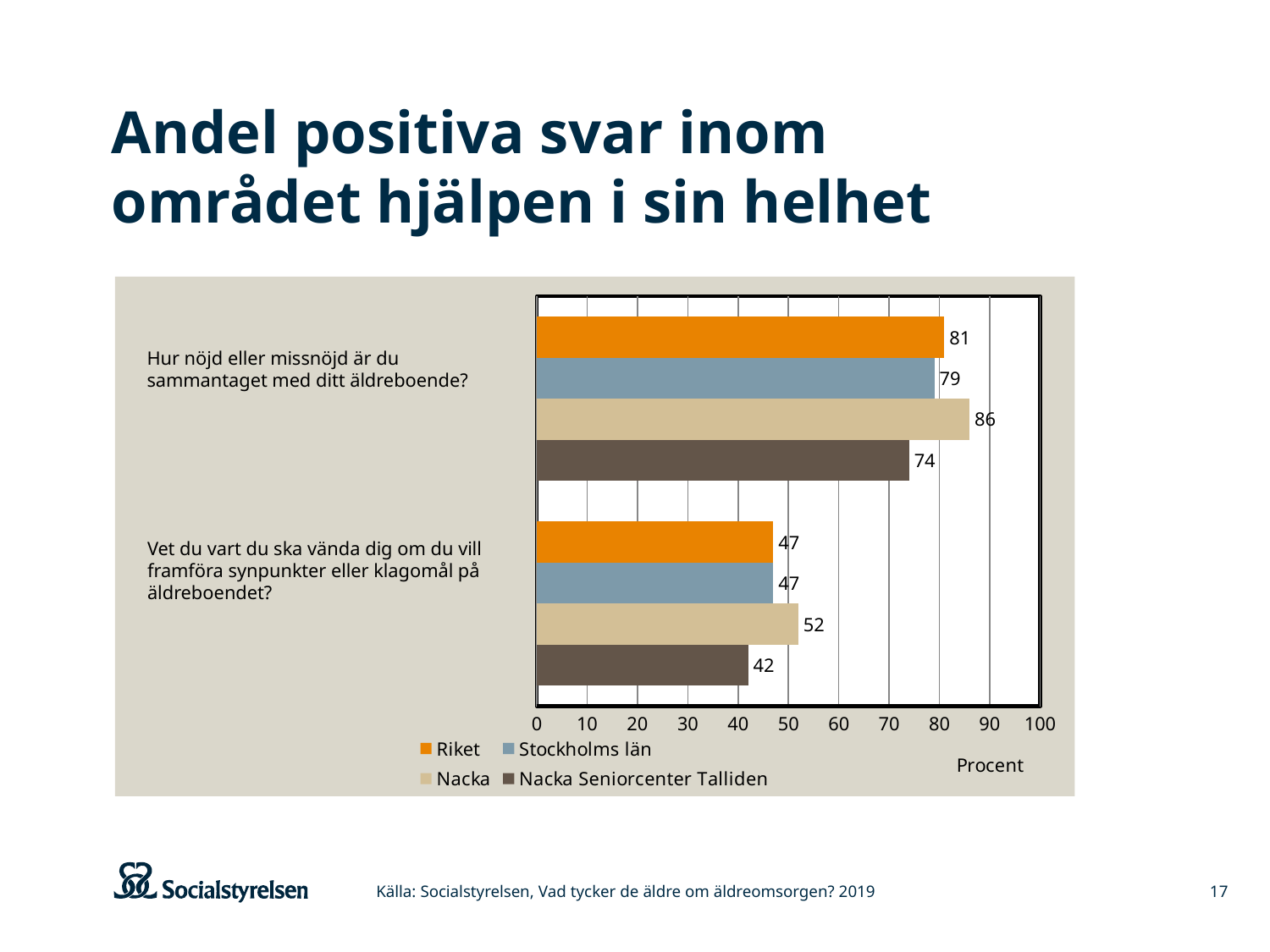
Is the value for Stockholms län on the question 'Hur nöjd eller missnöjd är du sammantaget med ditt äldreboende?' greater or less than 70? greater How many series does the legend list? 4 What is the difference between the Nacka and Nacka Seniorcenter Talliden values on the question 'Hur nöjd eller missnöjd är du sammantaget med ditt äldreboende?' 12 What is the value for Nacka on the question 'Hur nöjd eller missnöjd är du sammantaget med ditt äldreboende?' 86 Which is larger on the question 'Vet du vart du ska vända dig om du vill framföra synpunkter eller klagomål på äldreboendet?': Nacka or Riket? Nacka What is the label of the horizontal axis? Procent Which series has the highest value on the question 'Hur nöjd eller missnöjd är du sammantaget med ditt äldreboende?' Nacka What is the value for Nacka Seniorcenter Talliden on the question 'Vet du vart du ska vända dig om du vill framföra synpunkter eller klagomål på äldreboendet?' 42 What kind of chart is shown on the slide? Bar chart Which series has the lowest value on the question 'Vet du vart du ska vända dig om du vill framföra synpunkter eller klagomål på äldreboendet?' Nacka Seniorcenter Talliden What is the value for Riket on the question 'Hur nöjd eller missnöjd är du sammantaget med ditt äldreboende?' 81 What is the value for Stockholms län on the question 'Vet du vart du ska vända dig om du vill framföra synpunkter eller klagomål på äldreboendet?' 47